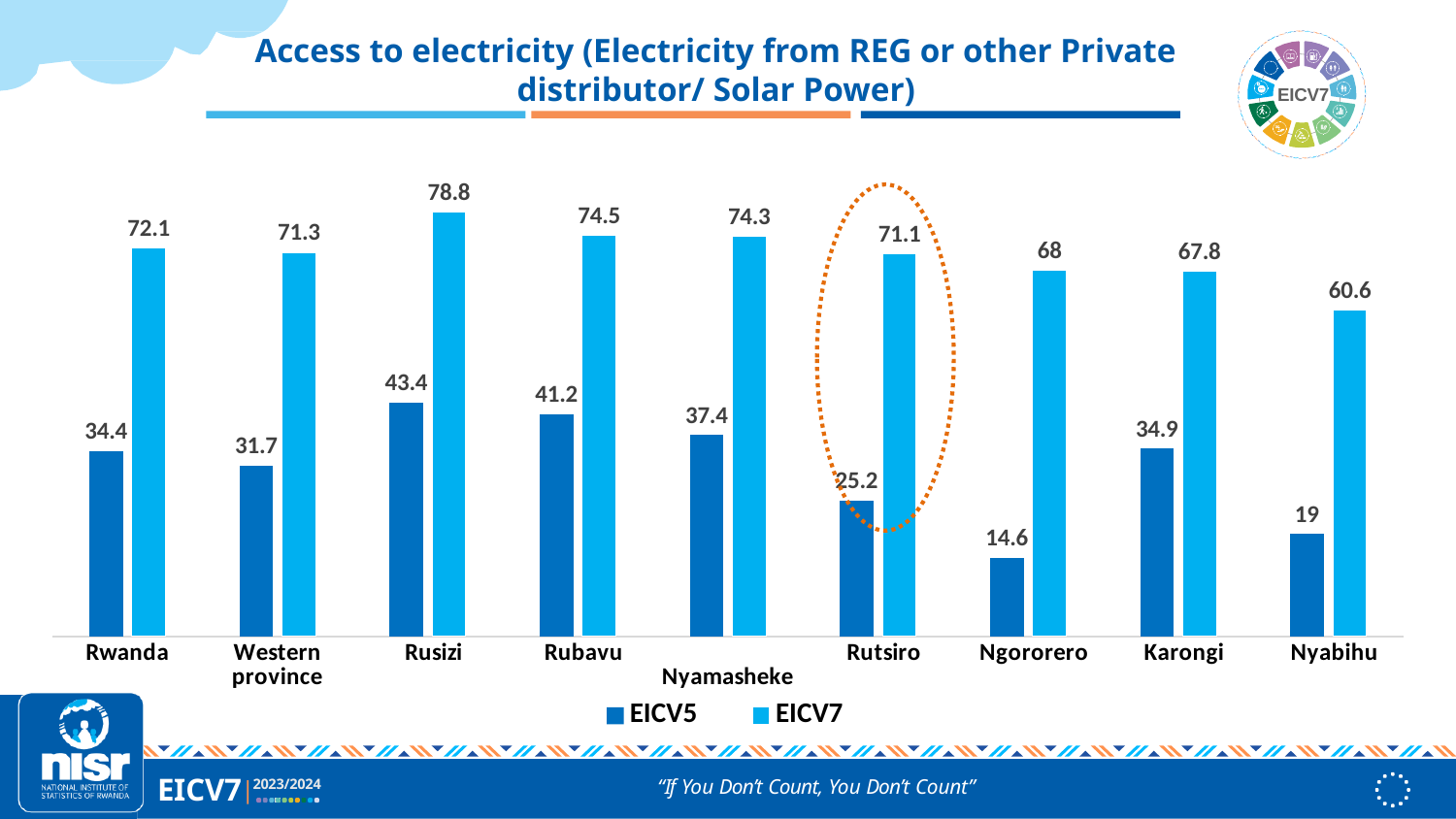
What is the EICV5 value for Ngororero? 14.6 What is the EICV5 value for Western province? 31.7 What is the difference between the EICV7 and EICV5 values for Rutsiro? 45.9 What is the EICV7 value for Nyabihu? 60.6 Which is larger, the EICV5 value for Rubavu or the EICV5 value for Nyamasheke? Rubavu Which category is highlighted with a dotted orange oval? Rutsiro How many series does the legend list? 2 Which category has the lowest EICV5 value? Ngororero How many categories are shown on the x axis? 9 Which category has the highest EICV7 value? Rusizi What kind of chart is shown on the slide? Bar chart What is the EICV7 value for Rusizi? 78.8